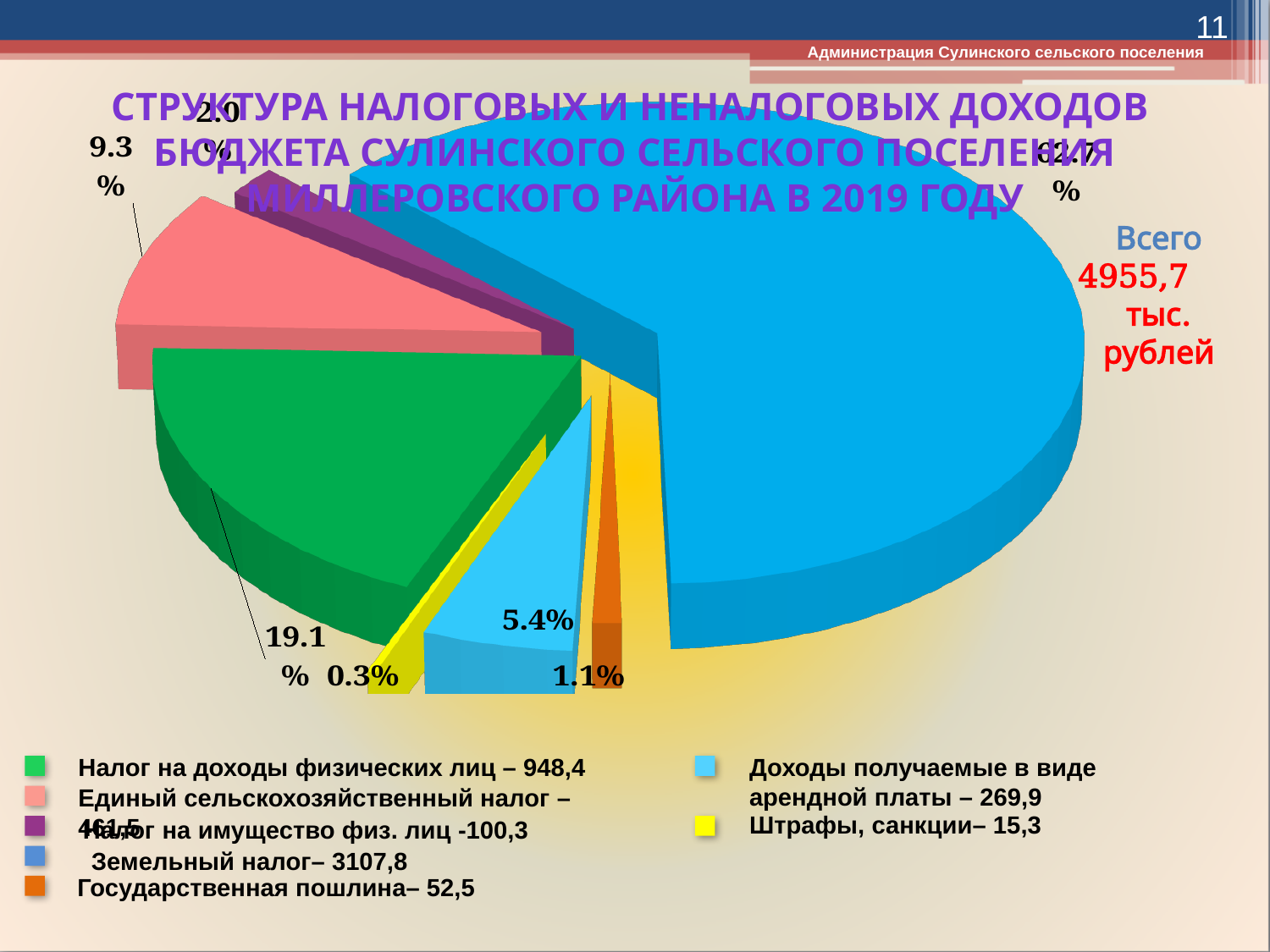
What total amount (Всего) is shown next to the pie chart? 4955,7 тыс. рублей What is the difference in percentage points between the slice for Налог на доходы физических лиц and the slice for Единый сельскохозяйственный налог? 9.8 How many slices does the pie chart have? 7 What share of the pie does Доходы получаемые в виде арендной платы have? 5.4% What kind of chart is shown on the slide? pie chart What share of the pie does Единый сельскохозяйственный налог have? 9.3% Which category has the smallest slice of the pie chart? Штрафы, санкции What share of the pie does Налог на доходы физических лиц have? 19.1% Which category has the largest slice of the pie chart? Земельный налог Which is larger: the slice for Единый сельскохозяйственный налог or the slice for Доходы получаемые в виде арендной платы? Единый сельскохозяйственный налог